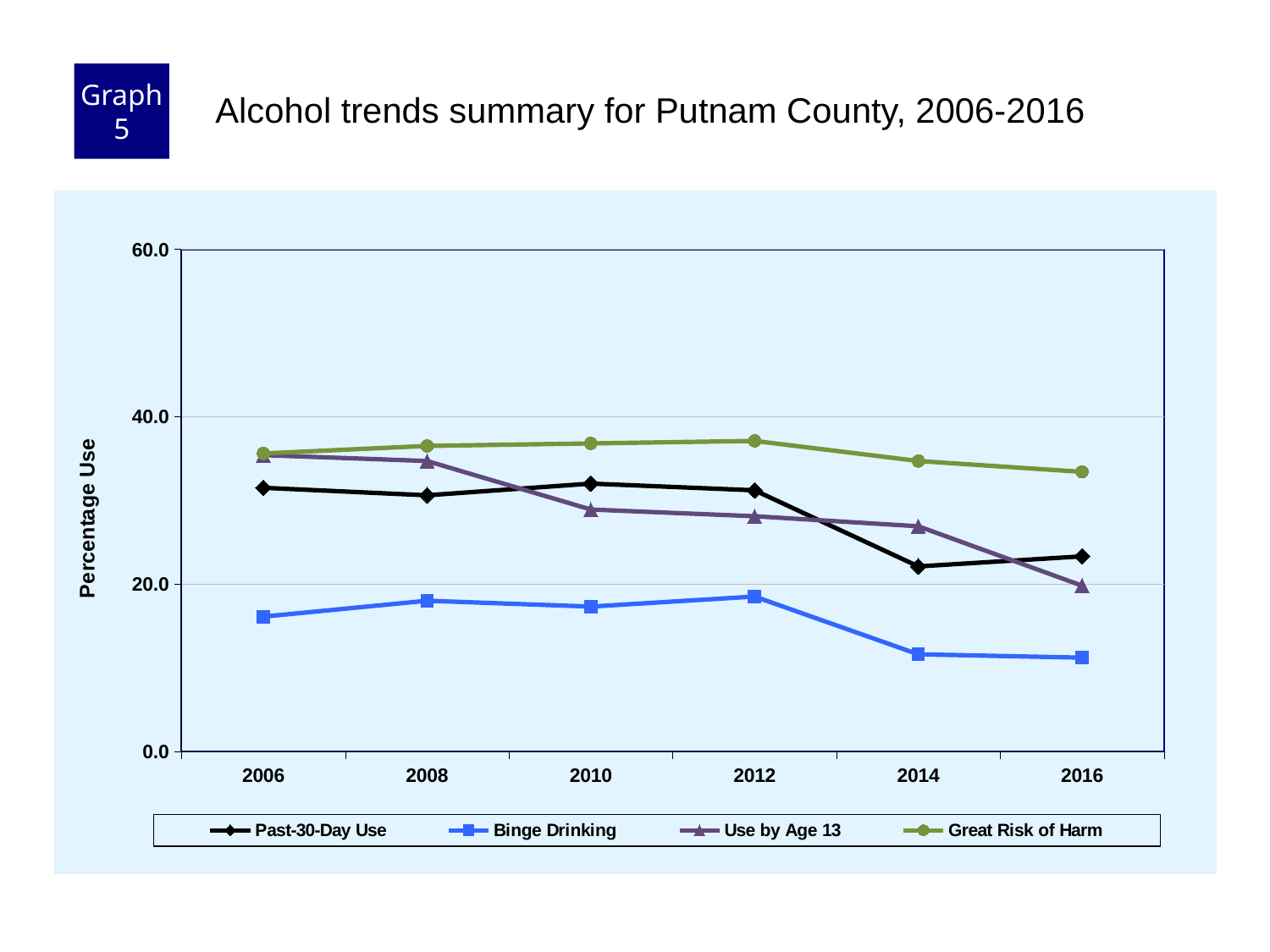
In 2016, which is larger: Past-30-Day Use or Use by Age 13? Past-30-Day Use Which series has the lowest value in 2016? Binge Drinking Is the value for Past-30-Day Use in 2014 greater or less than 20.0? greater In which year is Use by Age 13 at its lowest? 2016 Is the value for Binge Drinking in 2006 greater or less than 20.0? less Which series has the highest value in 2012? Great Risk of Harm What is the label on the y axis? Percentage Use What kind of chart is shown on the slide? Line chart How many years are plotted along the x axis? 6 Is the value for Great Risk of Harm in 2012 greater or less than 40.0? less How many series does the legend list? 4 Does Binge Drinking rise or fall from 2012 to 2014? Fall